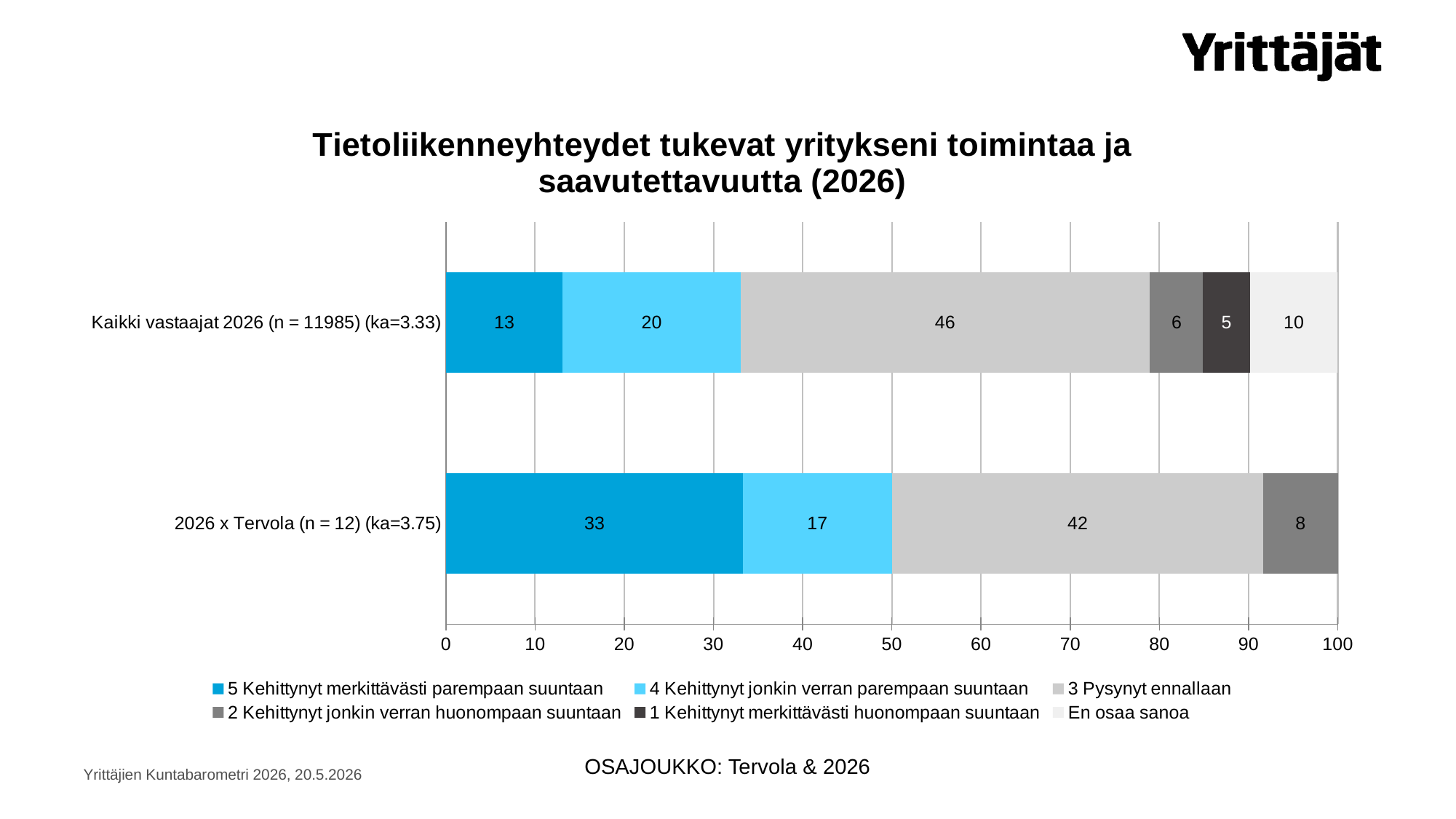
What is the difference between the '5 Kehittynyt merkittävästi parempaan suuntaan' values for '2026 x Tervola (n = 12) (ka=3.75)' and 'Kaikki vastaajat 2026 (n = 11985) (ka=3.33)'? 20 How many series does the legend list? 6 What is the total of the '2026 x Tervola (n = 12) (ka=3.75)' bar? 100 Which series has the smallest value in the 'Kaikki vastaajat 2026 (n = 11985) (ka=3.33)' bar? 1 Kehittynyt merkittävästi huonompaan suuntaan Which series has the largest value in the 'Kaikki vastaajat 2026 (n = 11985) (ka=3.33)' bar? 3 Pysynyt ennallaan How many categories (bars) are shown in the chart? 2 What kind of chart is shown on the slide? Stacked bar chart What is the value of '3 Pysynyt ennallaan' for 'Kaikki vastaajat 2026 (n = 11985) (ka=3.33)'? 46 What is the value of '2 Kehittynyt jonkin verran huonompaan suuntaan' for '2026 x Tervola (n = 12) (ka=3.75)'? 8 What is the value of '5 Kehittynyt merkittävästi parempaan suuntaan' for '2026 x Tervola (n = 12) (ka=3.75)'? 33 Which category has the larger value for '4 Kehittynyt jonkin verran parempaan suuntaan'? Kaikki vastaajat 2026 (n = 11985) (ka=3.33) What is the value of 'En osaa sanoa' for 'Kaikki vastaajat 2026 (n = 11985) (ka=3.33)'? 10